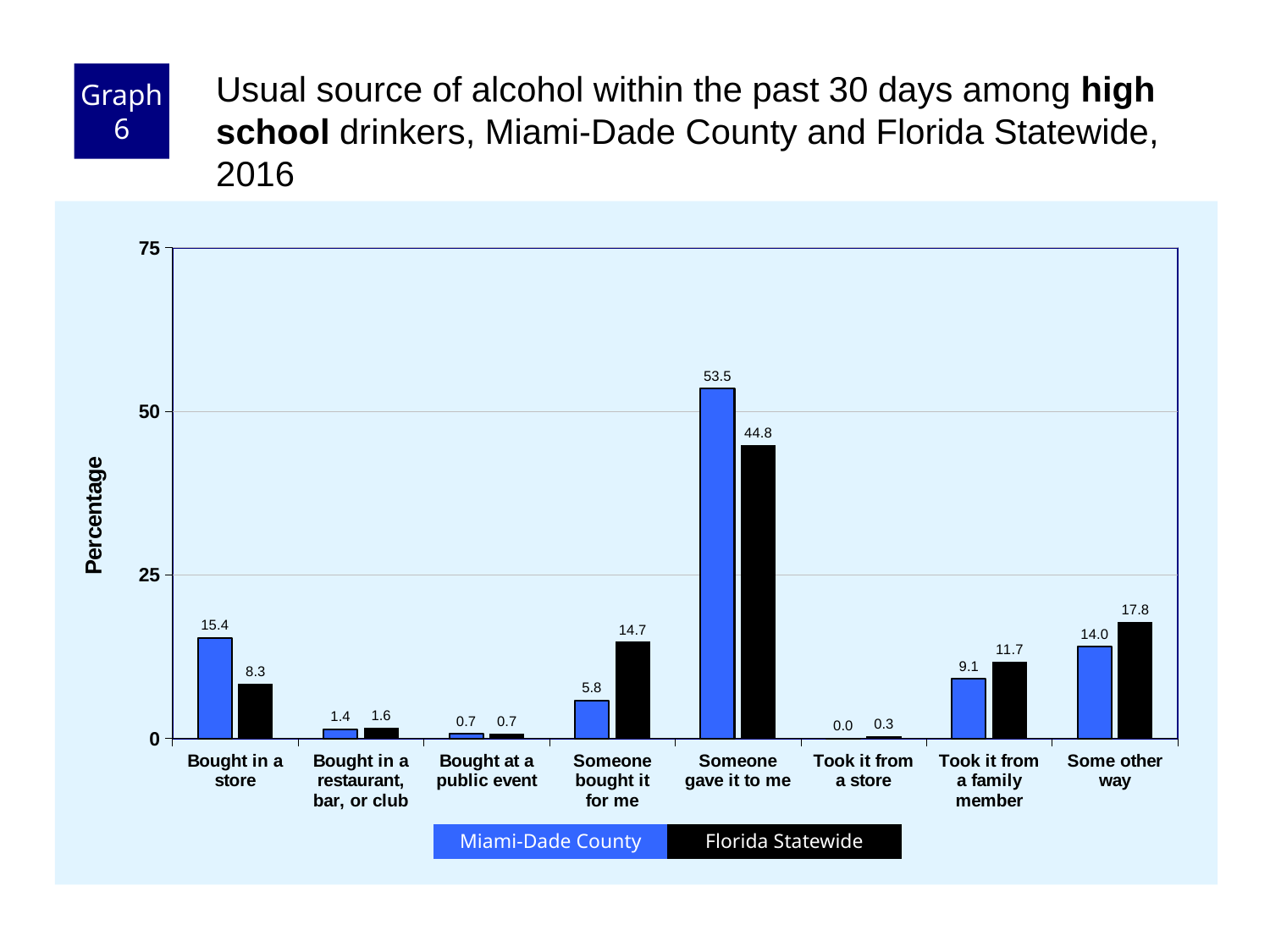
Is the Florida Statewide value for "Someone gave it to me" greater or less than 50? less What is the difference between the Miami-Dade County and Florida Statewide values for "Someone gave it to me"? 8.7 What is the Florida Statewide value for "Bought in a store"? 8.3 Which category has the lowest Miami-Dade County value? Took it from a store What is the label of the y axis? Percentage Which category has the highest Miami-Dade County value? Someone gave it to me How many series does the legend list? 2 What is the Florida Statewide value for "Took it from a store"? 0.3 What kind of chart is shown on the slide? bar chart What is the Miami-Dade County value for "Someone gave it to me"? 53.5 How many categories are shown on the x axis? 8 For "Someone bought it for me", which is larger: Miami-Dade County or Florida Statewide? Florida Statewide